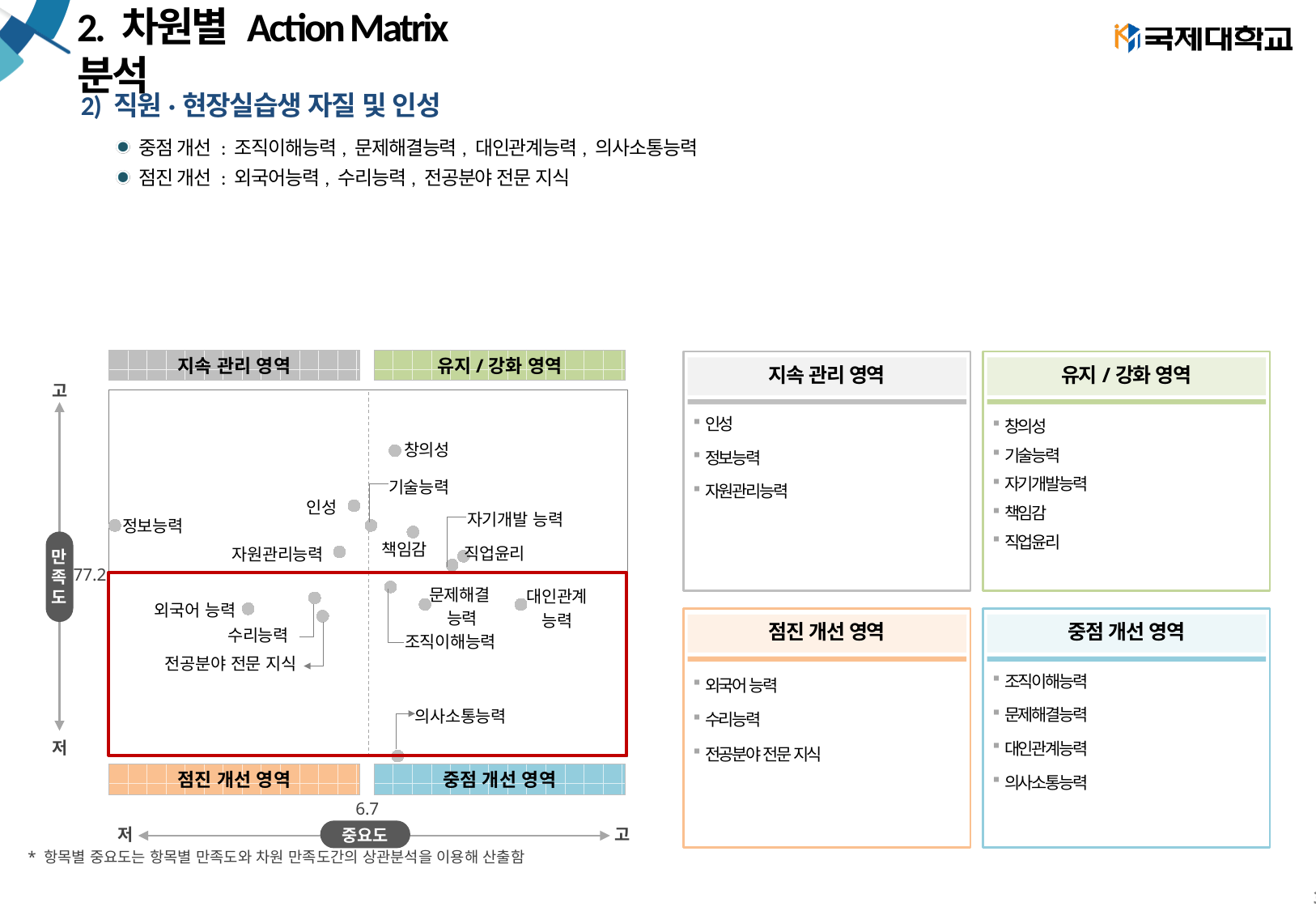
Which item has the highest satisfaction (만족도) in the action matrix? 창의성 Which has higher satisfaction, 창의성 or 의사소통능력? 창의성 Which item has the lowest importance (중요도) in the action matrix? 정보능력 What value marks the vertical reference line on the importance (중요도) axis? 6.7 What kind of chart is shown on the slide? scatter chart Is the satisfaction value for 창의성 greater or less than 77.2? greater How many labeled data points are plotted in the action matrix? 15 What value marks the horizontal reference line on the satisfaction (만족도) axis? 77.2 Is the importance value for 외국어 능력 greater or less than 6.7? less Which item has the lowest satisfaction (만족도) in the action matrix? 의사소통능력 Which item has the highest importance (중요도) in the action matrix? 대인관계능력 How many items are plotted in the 중점 개선 영역 quadrant? 4